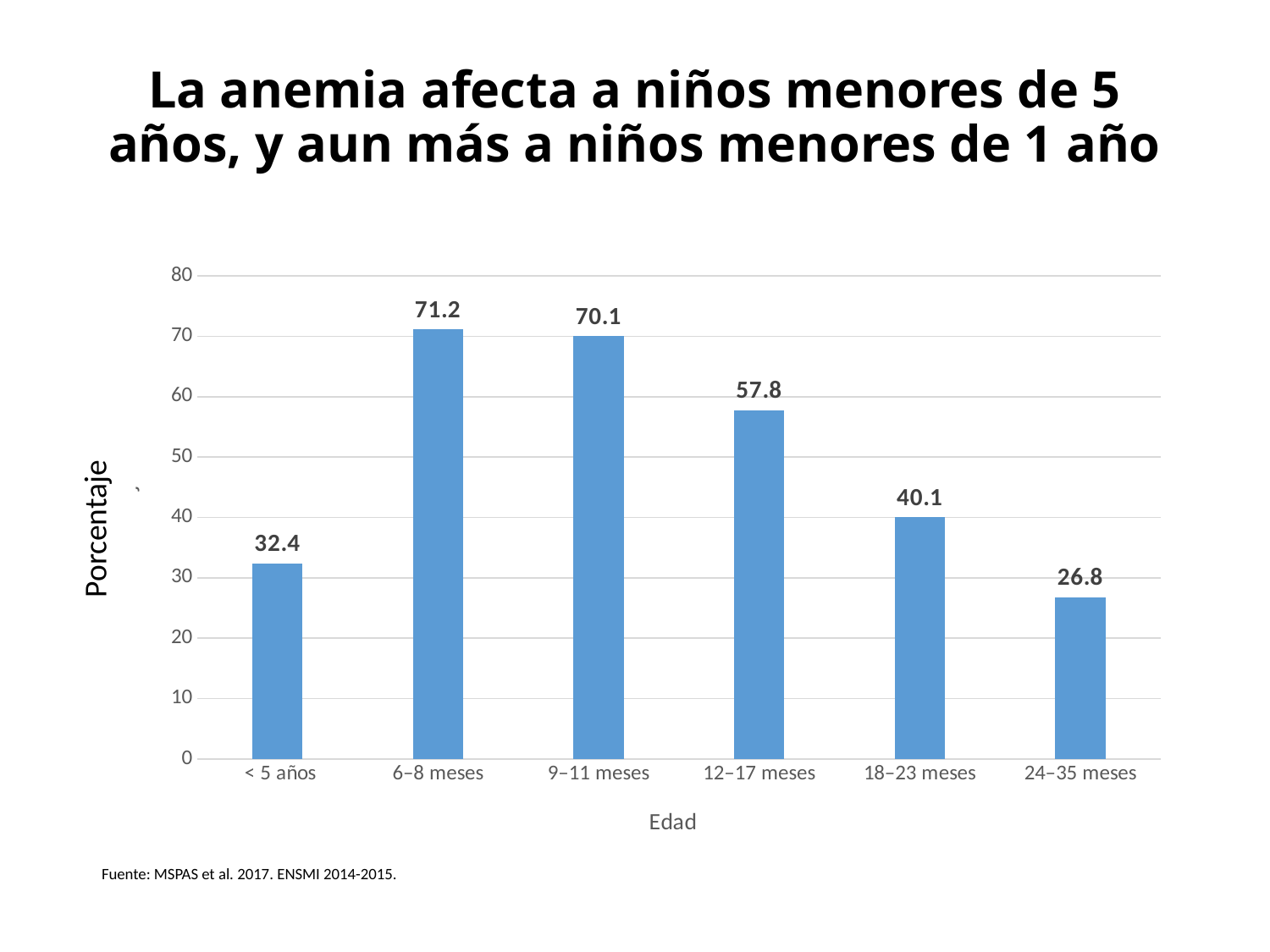
Is the value for 12–17 meses greater or less than 50? greater What is the value for the 18–23 meses category? 40.1 How many age categories are shown on the x axis? 6 Which age category has the lowest value? 24–35 meses What is the value for the < 5 años category? 32.4 Which is larger, the value for 9–11 meses or the value for 12–17 meses? 9–11 meses Which age category has the highest value? 6–8 meses What kind of chart is shown on the slide? bar chart What is the difference between the values for 12–17 meses and 18–23 meses? 17.7 What is the value for the 6–8 meses category? 71.2 What is the label of the y axis? Porcentaje What is the value for the 24–35 meses category? 26.8